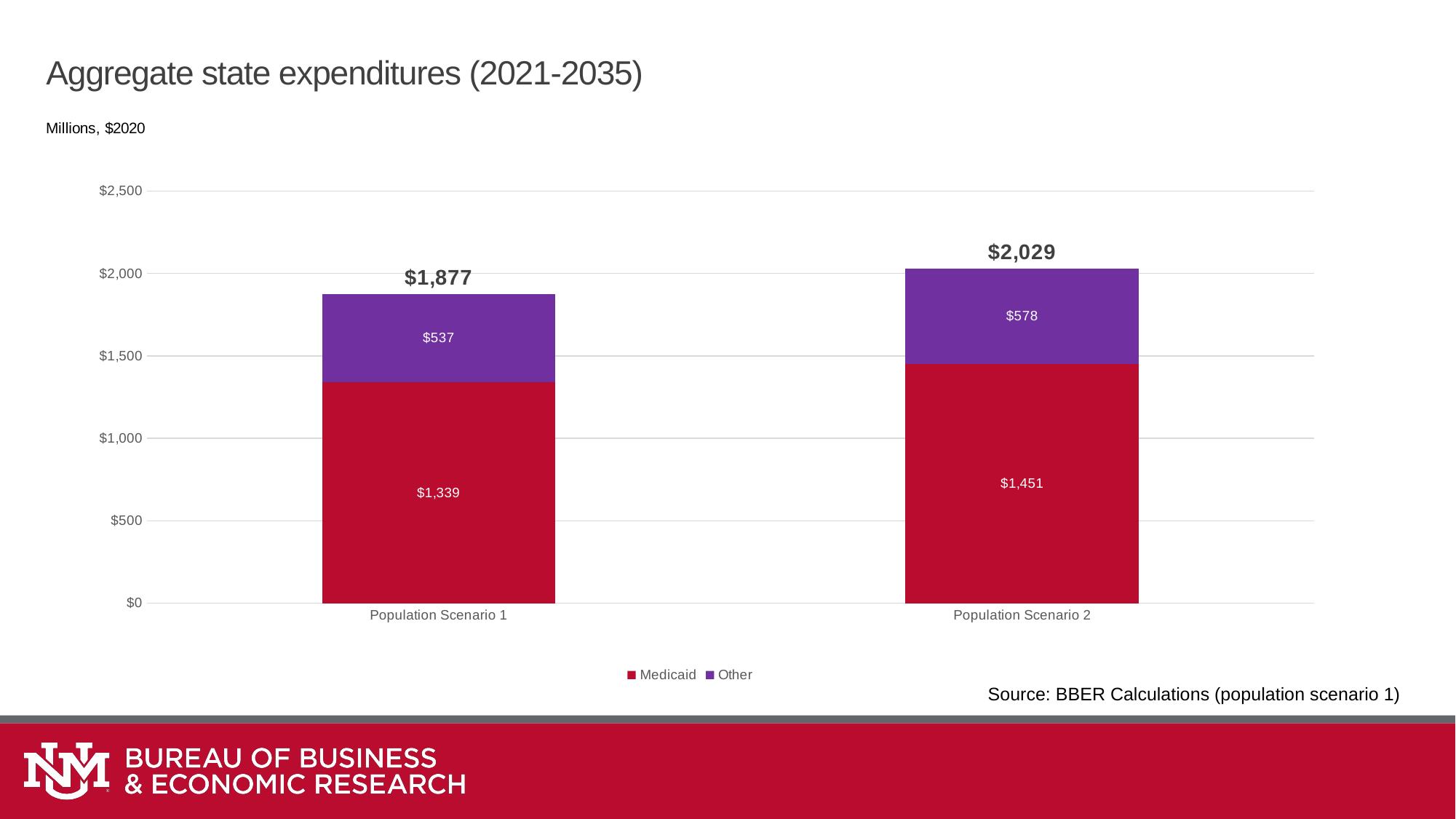
How many series does the legend list? 2 What kind of chart is shown on the slide? Stacked bar chart Is the Medicaid value for Population Scenario 1 greater or less than $1,000? greater What is the Medicaid value for Population Scenario 2? $1,451 What is the difference between the total expenditures of Population Scenario 2 and Population Scenario 1? $152 What is the Other value for Population Scenario 2? $578 What is the Other value for Population Scenario 1? $537 Which scenario has the higher total expenditure? Population Scenario 2 What is the total of the stacked bar for Population Scenario 1? $1,877 What is the difference in Medicaid expenditure between Population Scenario 2 and Population Scenario 1? $112 What is the total of the stacked bar for Population Scenario 2? $2,029 What is the Medicaid value for Population Scenario 1? $1,339